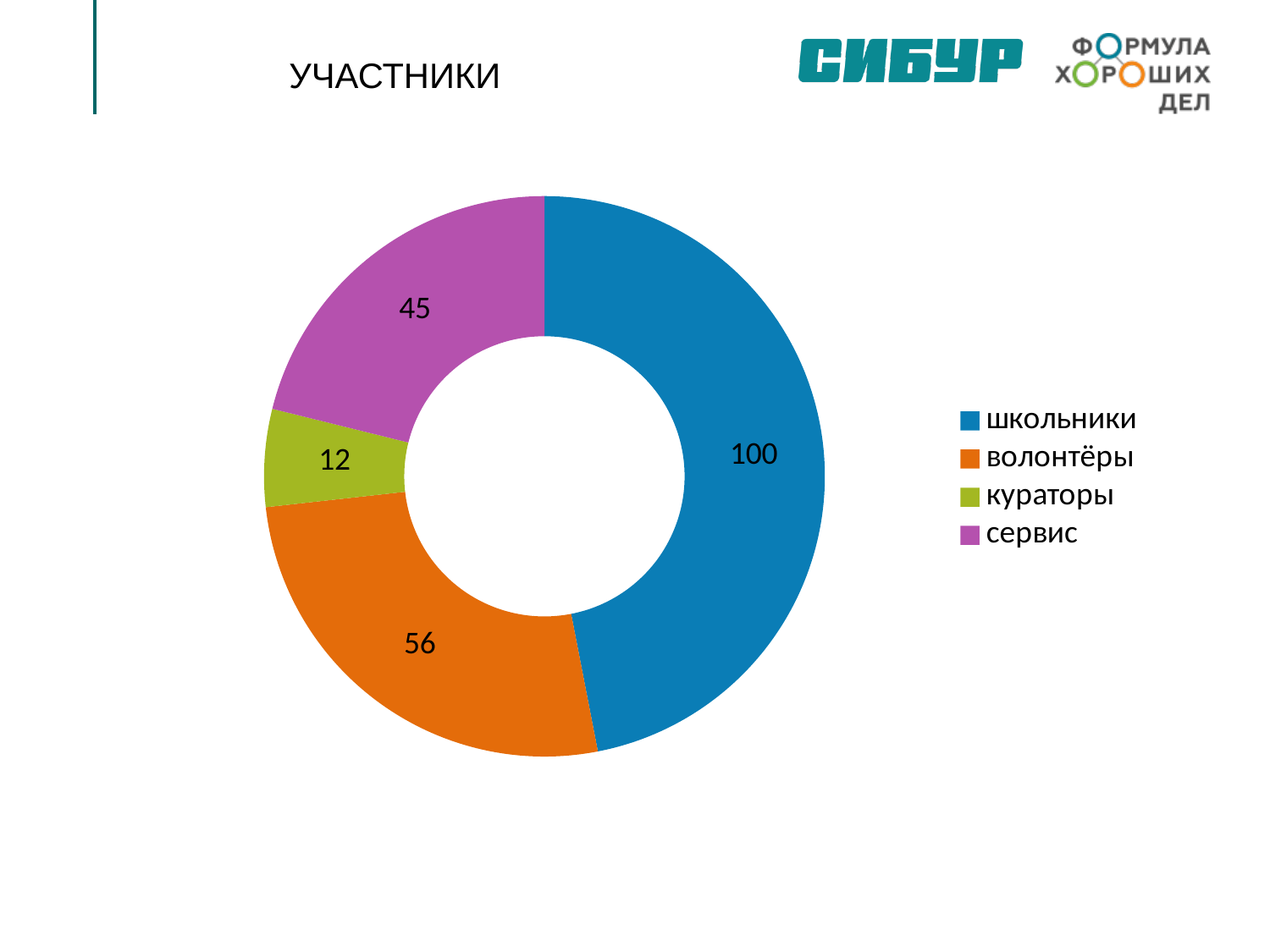
What is the difference between the values for школьники and волонтёры? 44 What is the value for кураторы in the chart? 12 What kind of chart is shown on the slide? doughnut chart Which category has the lowest value in the chart? кураторы What is the value for сервис in the chart? 45 Which is larger, the value for волонтёры or the value for сервис? волонтёры What is the title of the slide containing the chart? УЧАСТНИКИ How many categories are shown in the chart? 4 Which category has the highest value in the chart? школьники What is the value for волонтёры in the chart? 56 What is the value for школьники in the chart? 100 What is the difference between the values for сервис and кураторы? 33